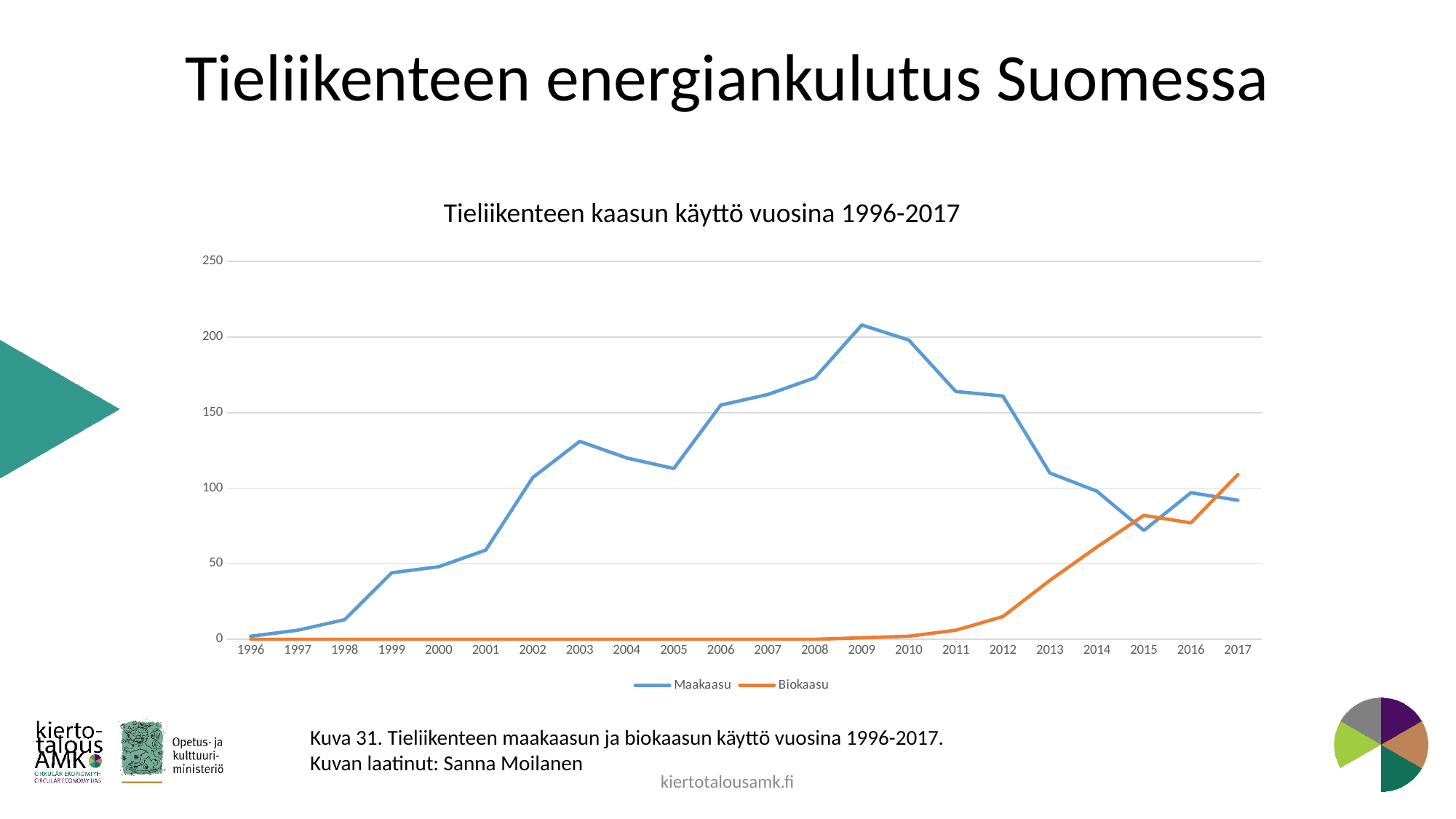
What kind of chart is shown on the slide? line chart How many years are plotted along the x axis? 22 Is the value for Maakaasu in 2009 greater or less than 200? greater In which year is the Maakaasu series at its lowest value? 1996 Is the value for Biokaasu in 2017 greater or less than 100? greater Is the value for Biokaasu in 2012 greater or less than 50? less Which series has the higher value in 2013, Maakaasu or Biokaasu? Maakaasu How many series does the legend list? 2 In which year does the Maakaasu series reach its highest value? 2009 Does the Biokaasu series rise or fall between 2011 and 2017? rise What is the title of the chart? Tieliikenteen kaasun käyttö vuosina 1996-2017